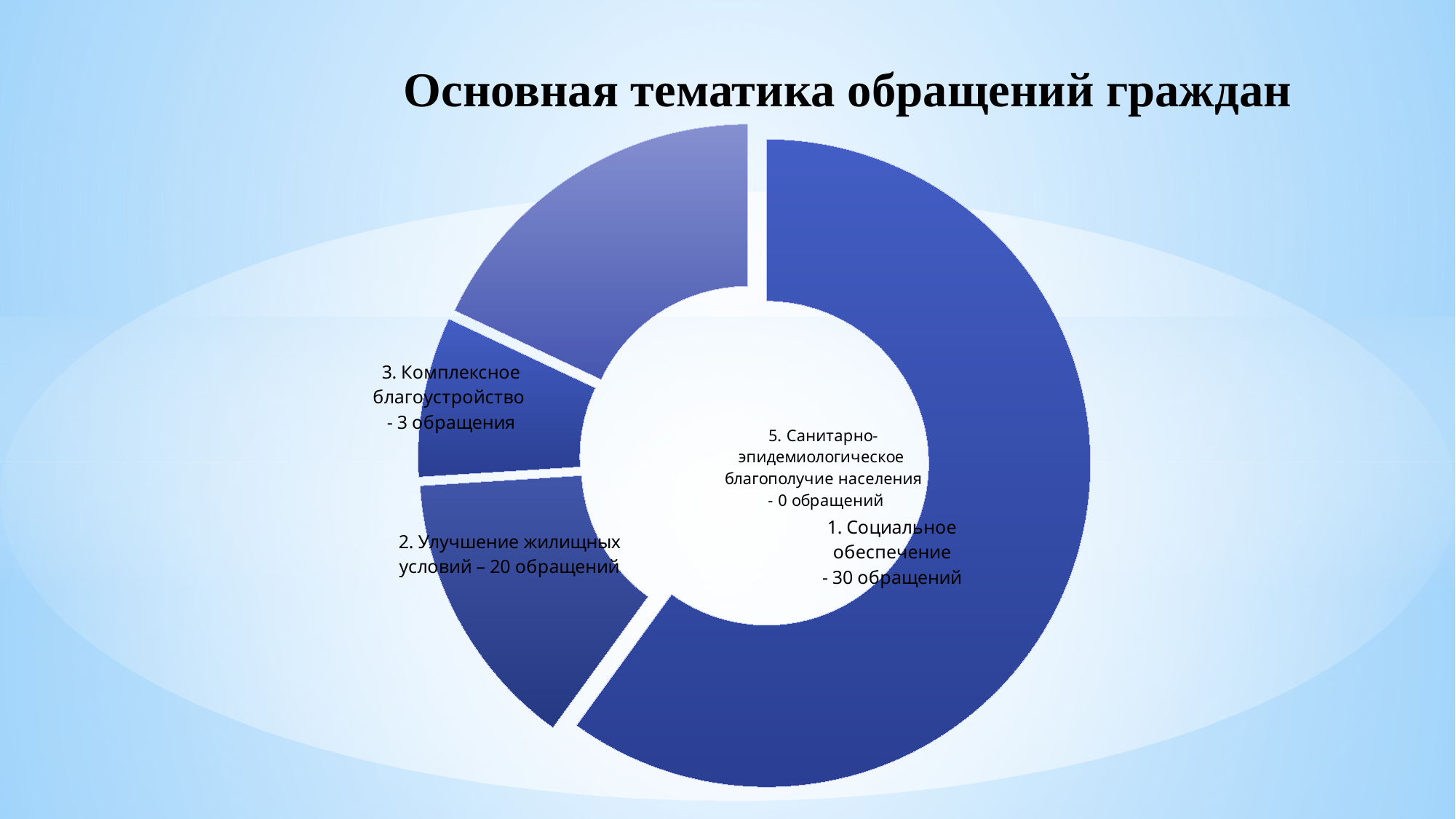
How many обращения are shown for «3. Комплексное благоустройство»? 3 обращения Which has more обращений: «1. Социальное обеспечение» or «2. Улучшение жилищных условий»? 1. Социальное обеспечение How many обращений are shown for «2. Улучшение жилищных условий»? 20 обращений Which labelled topic has the lowest number of обращений? 5. Санитарно-эпидемиологическое благополучие населения What is the difference in обращений between «2. Улучшение жилищных условий» and «3. Комплексное благоустройство»? 17 How many обращений are shown for «1. Социальное обеспечение»? 30 обращений How many обращений are shown for «5. Санитарно-эпидемиологическое благополучие населения»? 0 обращений What is the title of the slide? Основная тематика обращений граждан Which has more обращений: «2. Улучшение жилищных условий» or «3. Комплексное благоустройство»? 2. Улучшение жилищных условий What kind of chart is shown on the slide? Doughnut chart What is the difference in обращений between «1. Социальное обеспечение» and «2. Улучшение жилищных условий»? 10 Which labelled topic has the highest number of обращений? 1. Социальное обеспечение